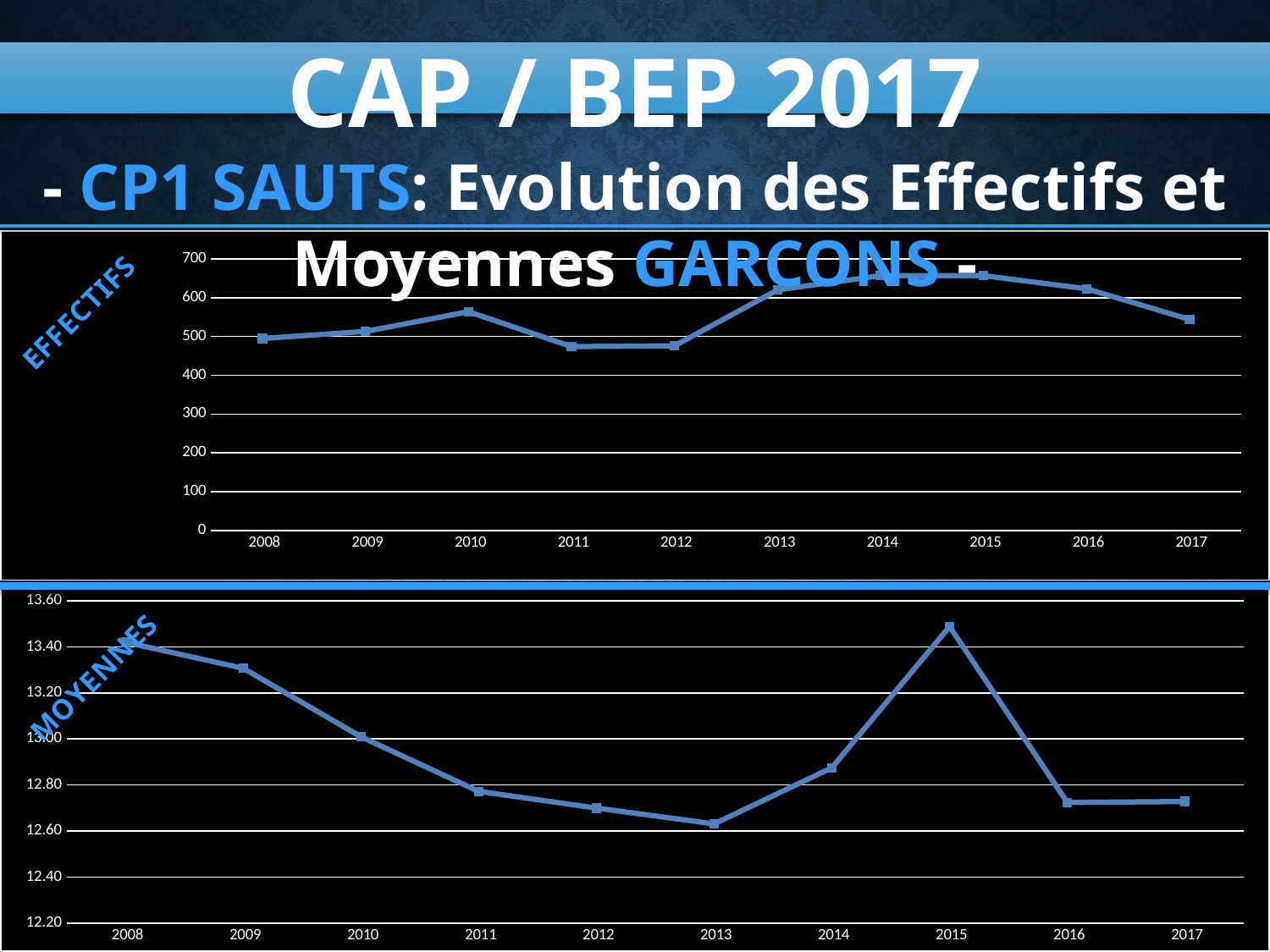
On the top chart (EFFECTIFS), which is larger, the value for 2010 or the value for 2011? 2010 On the bottom chart (MOYENNES), which year has the lowest value? 2013 On the top chart (EFFECTIFS), is the value for 2010 greater or less than 500? greater On the bottom chart (MOYENNES), which is larger, the value for 2009 or the value for 2014? 2009 On the bottom chart (MOYENNES), is the value for 2013 greater or less than 12.80? less What kind of chart is the top chart (EFFECTIFS)? line chart On the bottom chart (MOYENNES), do the values rise or fall from 2008 to 2013? fall On the bottom chart (MOYENNES), which year has the highest value? 2015 On the bottom chart (MOYENNES), is the value for 2015 greater or less than 13.40? greater How many years are plotted on the bottom chart (MOYENNES)? 10